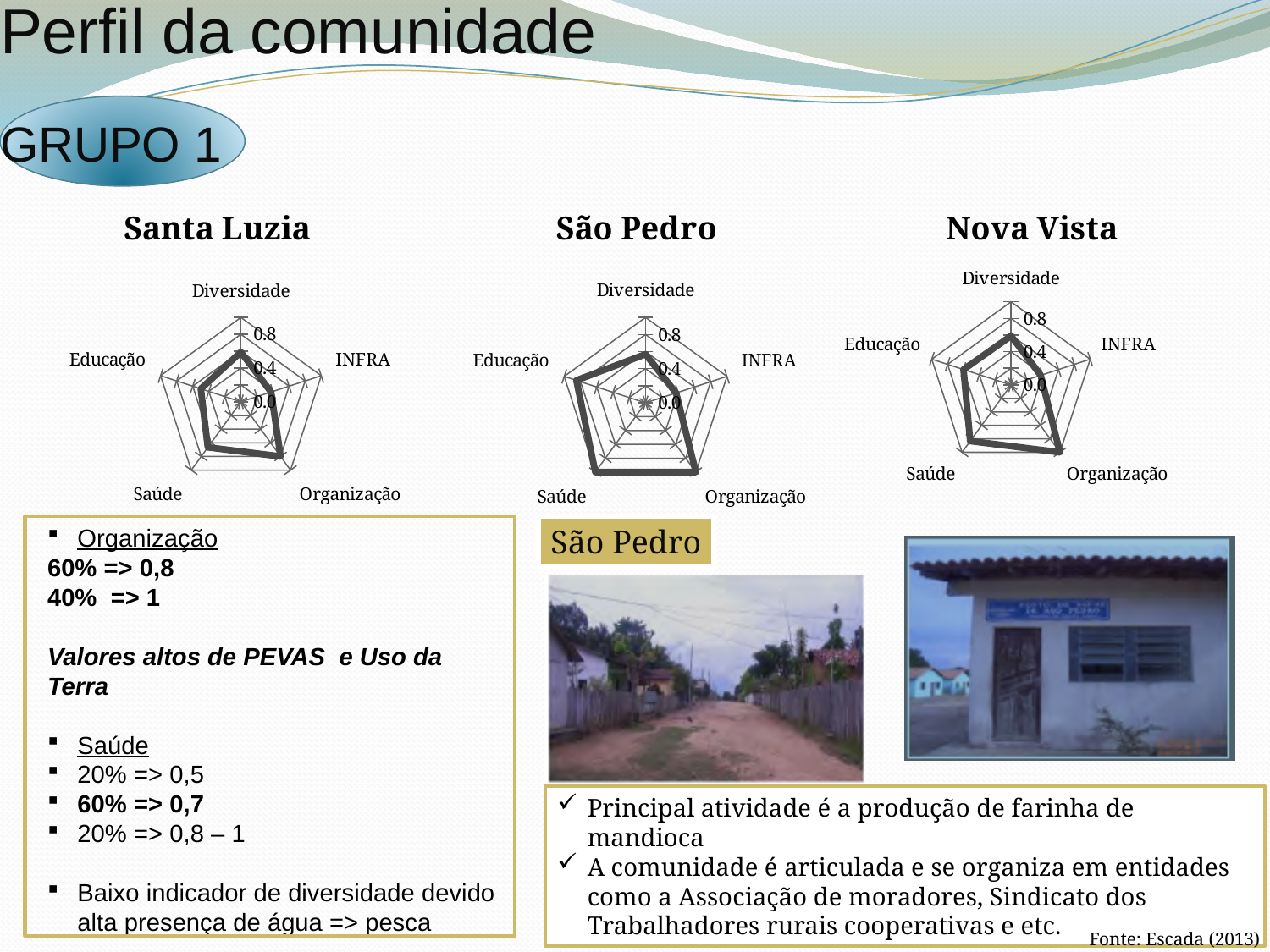
In the São Pedro chart, which indicator has the lowest value? INFRA In the Santa Luzia chart, is the value for Saúde greater or less than 0.4? greater In the Nova Vista chart, is the value for Organização greater or less than 0.4? greater In the São Pedro chart, is the value for Saúde greater or less than 0.4? greater In the Nova Vista chart, which indicator has the lowest value? INFRA How many indicator axes does the São Pedro radar chart have? 5 What is the highest tick value shown on the radar chart axes? 0.8 How many radar charts are shown on the slide? 3 In the Nova Vista chart, which is larger, the value for Saúde or the value for INFRA? Saúde What type of chart is used for Santa Luzia, São Pedro and Nova Vista? Radar chart